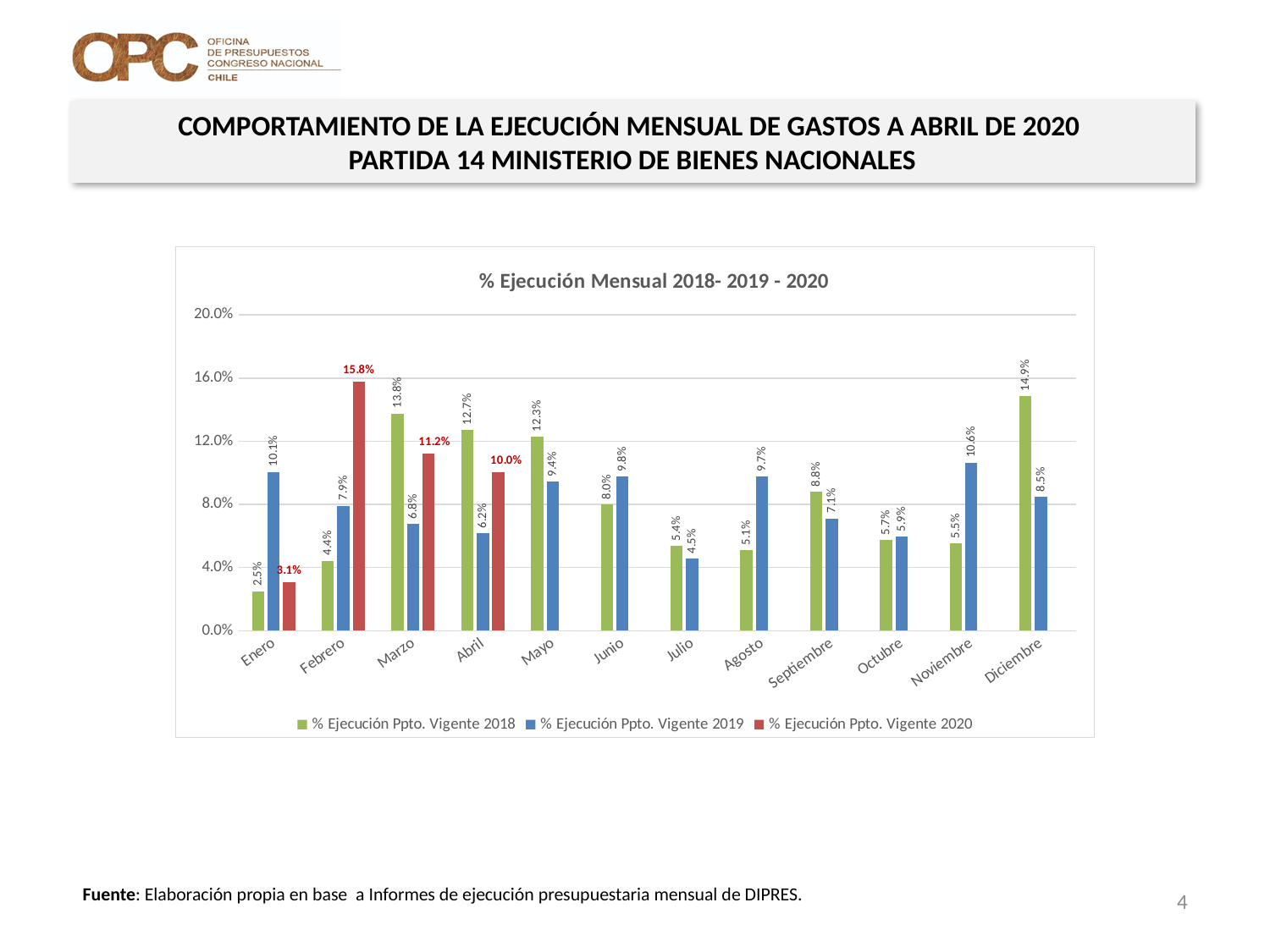
Is the value for Enero in the % Ejecución Ppto. Vigente 2019 series greater or less than 8.0%? greater How many months are shown on the x axis? 12 What is the title of the chart? % Ejecución Mensual 2018- 2019 - 2020 What is the difference between the 2020 and 2019 values for Marzo? 4.4% What is the value for Noviembre in the % Ejecución Ppto. Vigente 2019 series? 10.6% Which month has the highest value in the % Ejecución Ppto. Vigente 2018 series? Diciembre For Abril, which series has the larger value: % Ejecución Ppto. Vigente 2018 or % Ejecución Ppto. Vigente 2020? % Ejecución Ppto. Vigente 2018 What is the value for Diciembre in the % Ejecución Ppto. Vigente 2018 series? 14.9% What is the value for Febrero in the % Ejecución Ppto. Vigente 2020 series? 15.8% How many series does the legend list? 3 Which month has the lowest value in the % Ejecución Ppto. Vigente 2019 series? Julio What kind of chart is shown on the slide? Bar chart